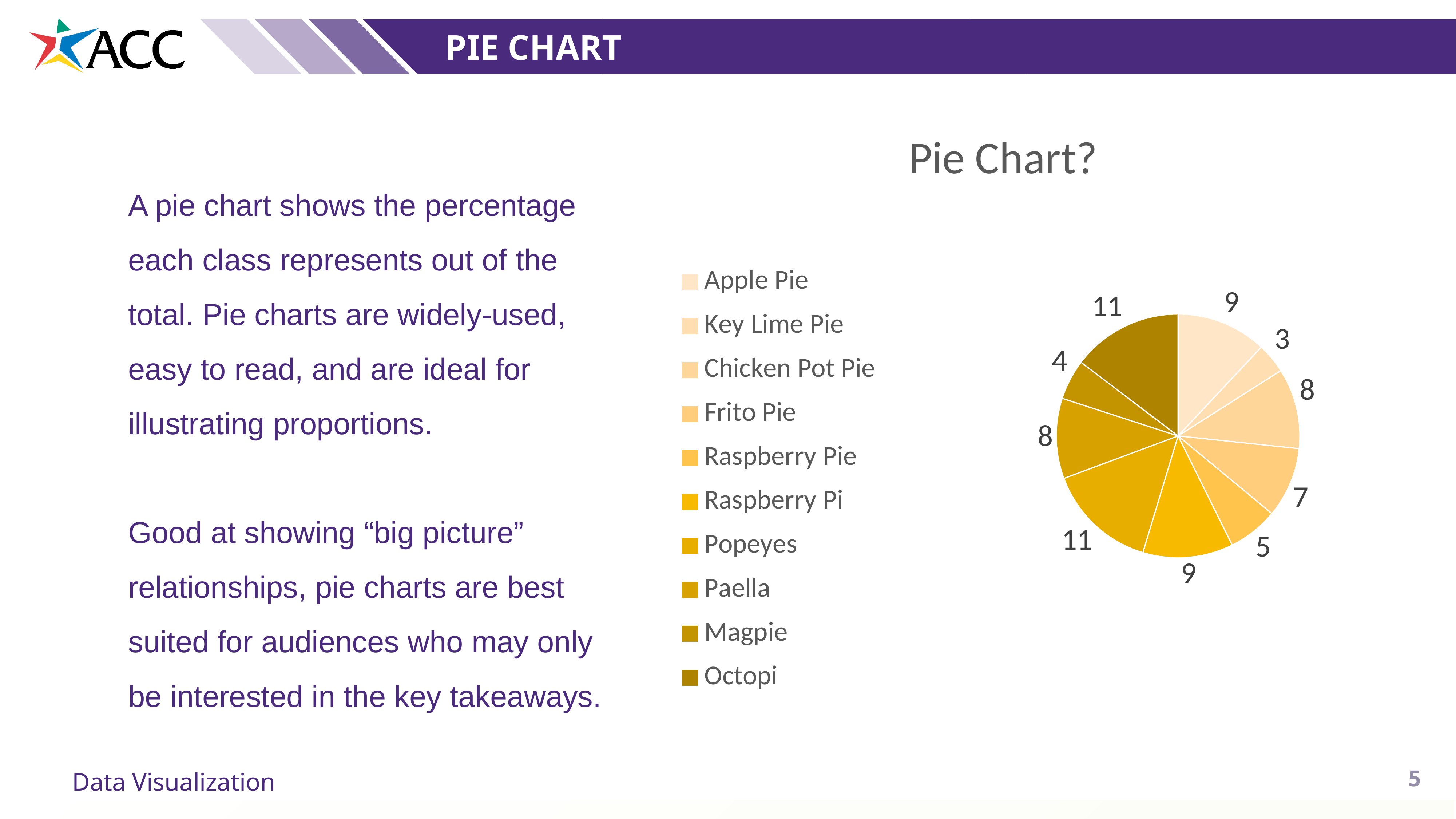
Which slice is larger, Chicken Pot Pie or Raspberry Pie? Chicken Pot Pie What is the total of all the slice values in the pie chart? 75 How many categories does the legend of the pie chart list? 10 What is the title of the chart? Pie Chart? What share of the pie does the Apple Pie slice represent? 12% What is the value of the Magpie slice? 4 Which category has the smallest slice in the pie chart? Key Lime Pie What is the value of the Frito Pie slice? 7 What is the value of the Key Lime Pie slice? 3 What kind of chart is shown on the slide? pie chart What is the value of the Apple Pie slice? 9 What is the difference between the Popeyes slice and the Raspberry Pie slice? 6